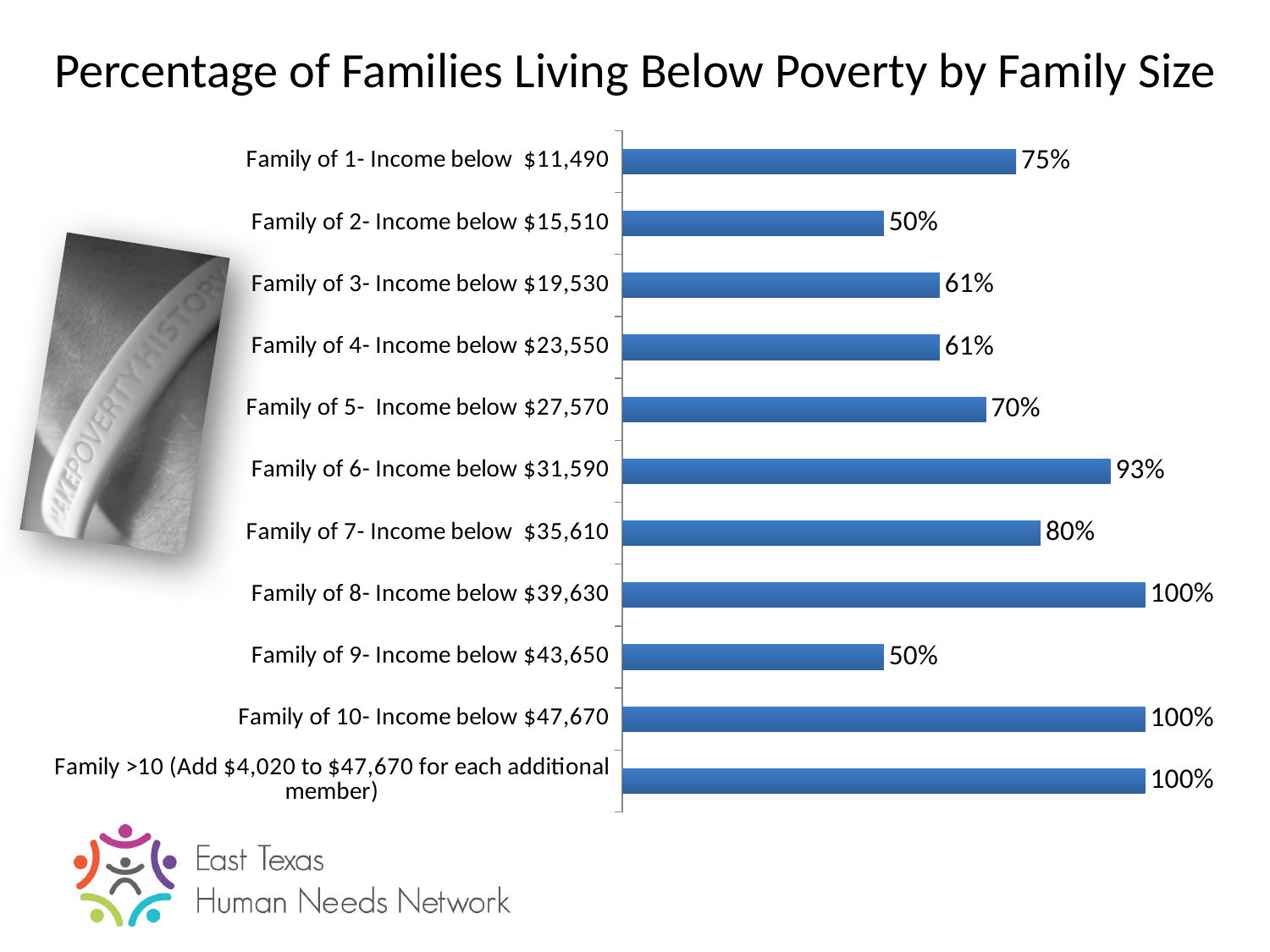
What type of chart is shown on the slide? Bar chart What is the difference between the values for Family of 1 and Family of 2? 25% What is the highest percentage value shown on the chart? 100% How many family size categories are shown on the chart? 11 What is the difference between the values for Family of 6 and Family of 5? 23% Which family size categories have the lowest percentage on the chart? Family of 2 and Family of 9 (50%) What is the value shown for Family of 6- Income below $31,590? 93% What percentage of families of 1 (income below $11,490) live below poverty? 75% Which is larger, the value for Family of 7 or the value for Family of 5? Family of 7 What is the value for Family of 7- Income below $35,610? 80% What is the title of the chart? Percentage of Families Living Below Poverty by Family Size What percentage is shown for Family of 9- Income below $43,650? 50%